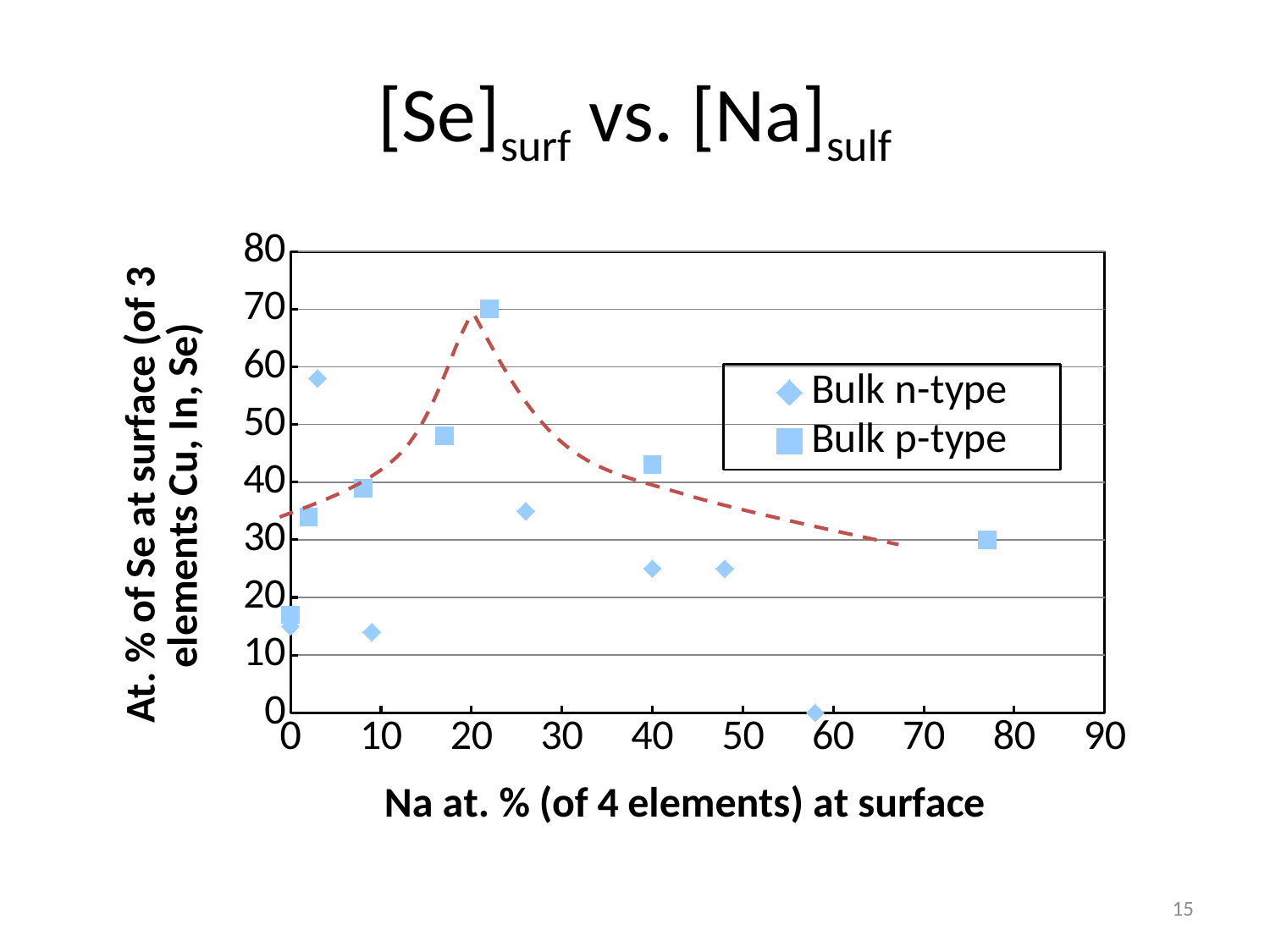
What kind of chart is shown on the slide? scatter chart Is the highest Bulk p-type point greater or less than 60 on the Se at. % axis? greater Is the Bulk p-type point near 77 on the Na axis greater or less than 40 on the Se at. % axis? less Which series contains the point with the highest Se at. % value? Bulk p-type Is the Bulk n-type point near 58 on the Na axis greater or less than 10 on the Se at. % axis? less Beyond the peak near Na 20, does the dashed trend line rise or fall as Na at. % increases? fall Which series contains the point with the lowest Se at. % value? Bulk n-type What is the title of the x axis? Na at. % (of 4 elements) at surface How many series does the legend list? 2 Which is larger: the Se at. % of the Bulk p-type point near Na 22 or the Bulk n-type point near Na 26? Bulk p-type point near Na 22 What are the two series named in the legend? Bulk n-type and Bulk p-type